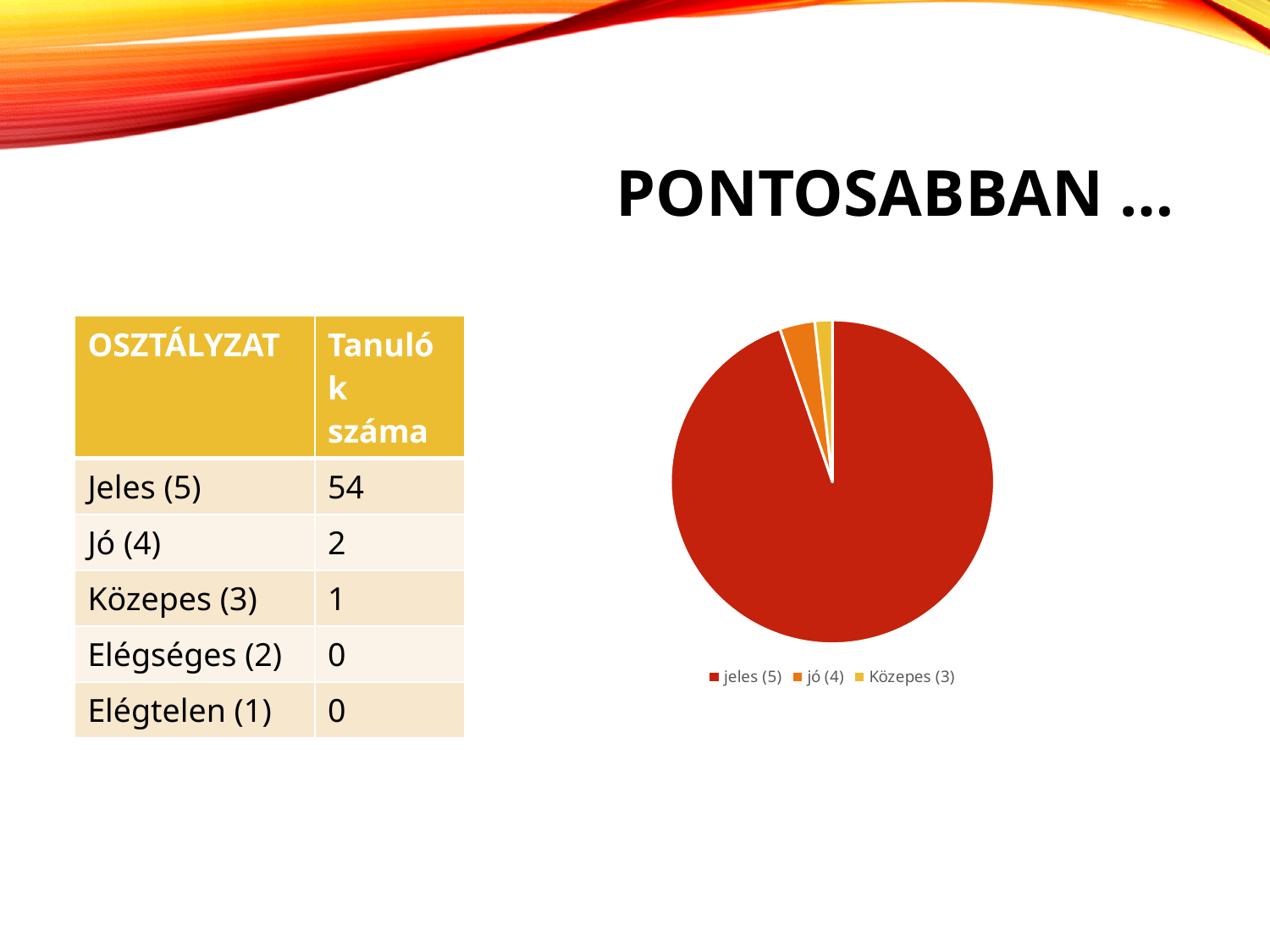
Which slice is larger in the pie chart, jeles (5) or jó (4)? jeles (5) How many slices does the pie chart have? 3 Using the values in the table, how many more students received Jeles (5) than Jó (4)? 52 Which category has the smallest slice in the pie chart? Közepes (3) According to the table on the slide, how many students received Jeles (5)? 54 What colour is the largest slice of the pie chart? red What kind of chart is shown on the slide? pie chart According to the table on the slide, how many students received Közepes (3)? 1 Which category has the largest slice in the pie chart? jeles (5) According to the table on the slide, how many students received Jó (4)? 2 Which slice is larger in the pie chart, jó (4) or Közepes (3)? jó (4) How many entries does the pie chart's legend list? 3